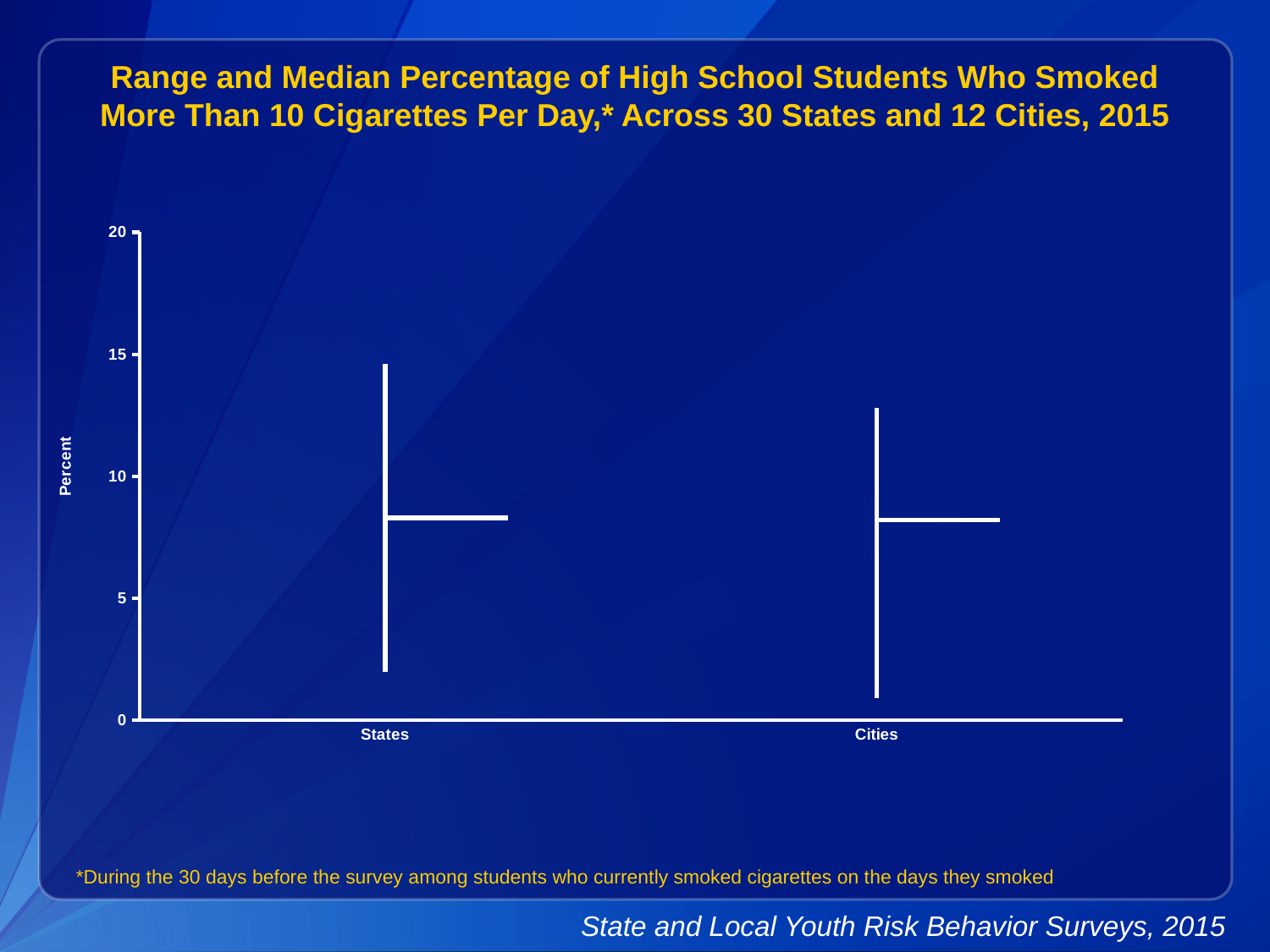
Is the bottom of the range for Cities greater or less than 5? less Which category has the higher top of its range, States or Cities? States Is the top of the range for States greater or less than 15? less What is the label on the y axis of the chart? Percent Is the median value for Cities greater or less than 10? less What are the two categories shown on the x axis? States and Cities How many categories are shown on the x axis of the chart? 2